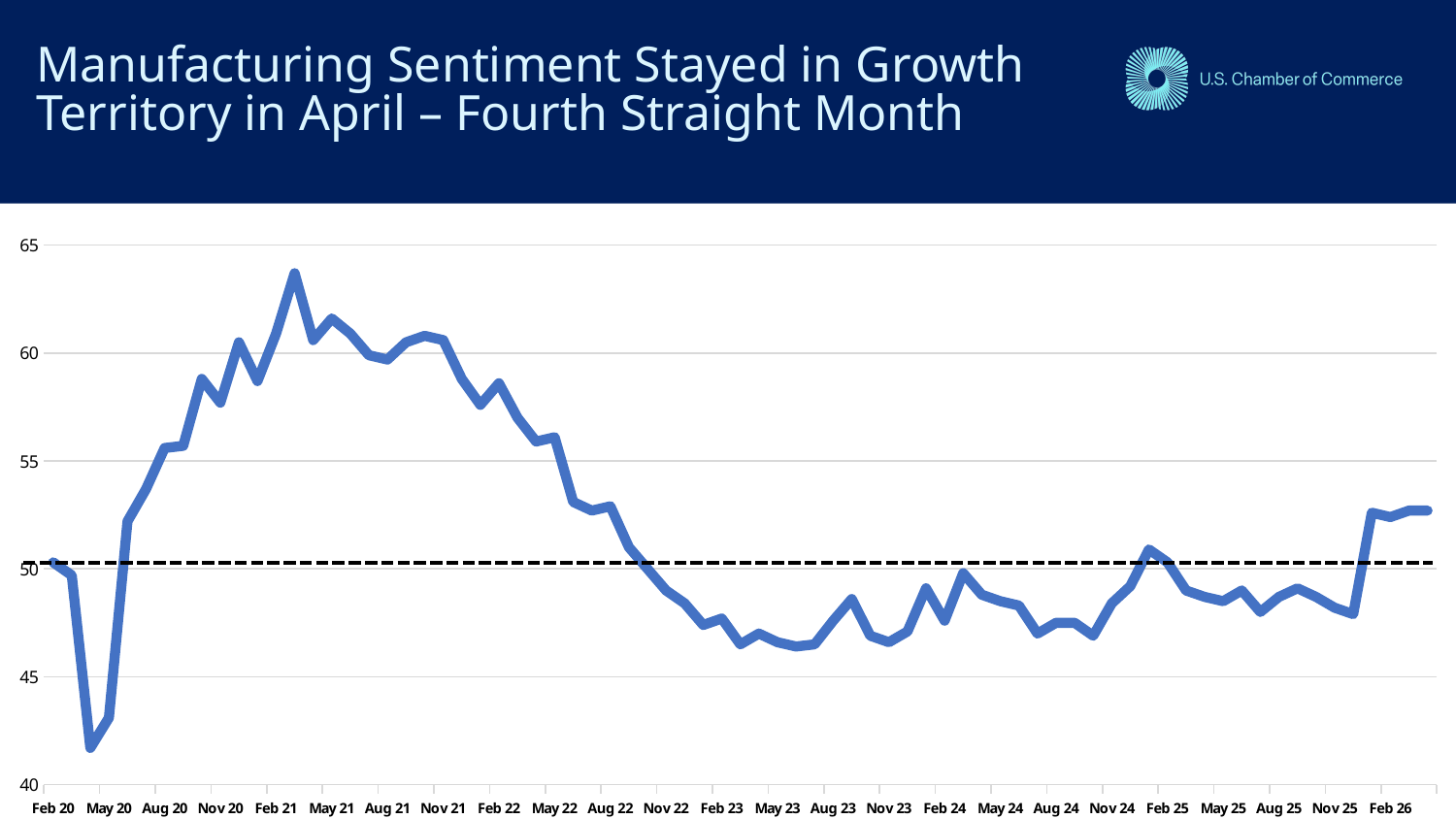
How many month labels are shown on the x axis? 25 Is the value for May 20 greater or less than 45? less Is the value for Feb 23 greater or less than 50? less Is the value for Nov 24 greater or less than 50? less In which year does the line reach its highest point? 2021 In which year does the line reach its lowest point? 2020 Does the line rise or fall between Feb 21 and Feb 23? fall At what value is the horizontal dashed line drawn? 50 What kind of chart is shown on the slide? line chart